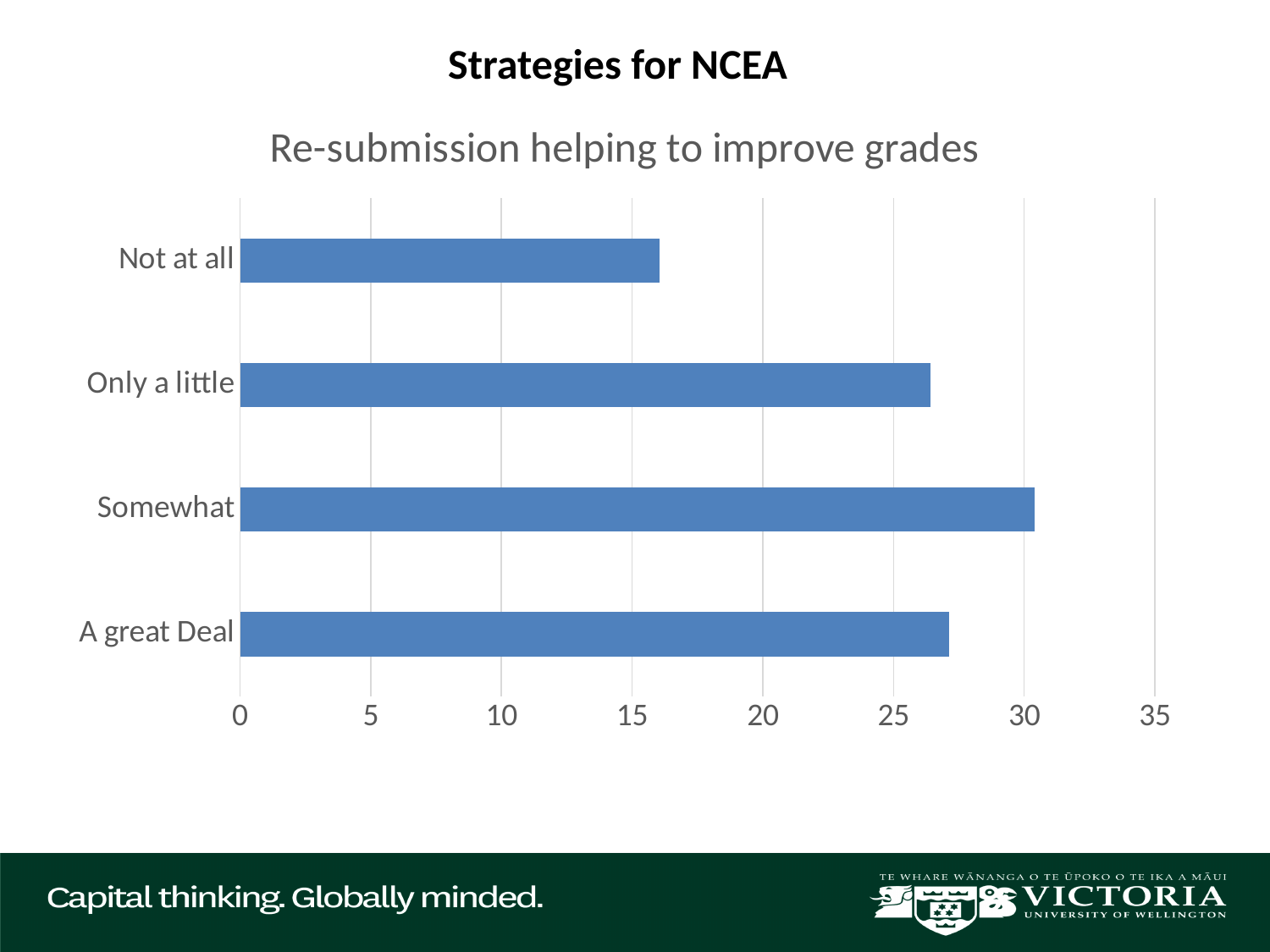
Which is larger, the value for Somewhat or the value for A great Deal? Somewhat Is the value for Only a little greater or less than 25? greater What is the highest value shown on the horizontal axis? 35 Which is larger, the value for Not at all or the value for Only a little? Only a little Is the value for Not at all greater or less than 20? less What kind of chart is shown on the slide? bar chart Which category has the lowest value? Not at all What is the title of the chart? Re-submission helping to improve grades How many categories are plotted in the chart? 4 Is the value for A great Deal greater or less than 30? less Which category has the highest value? Somewhat